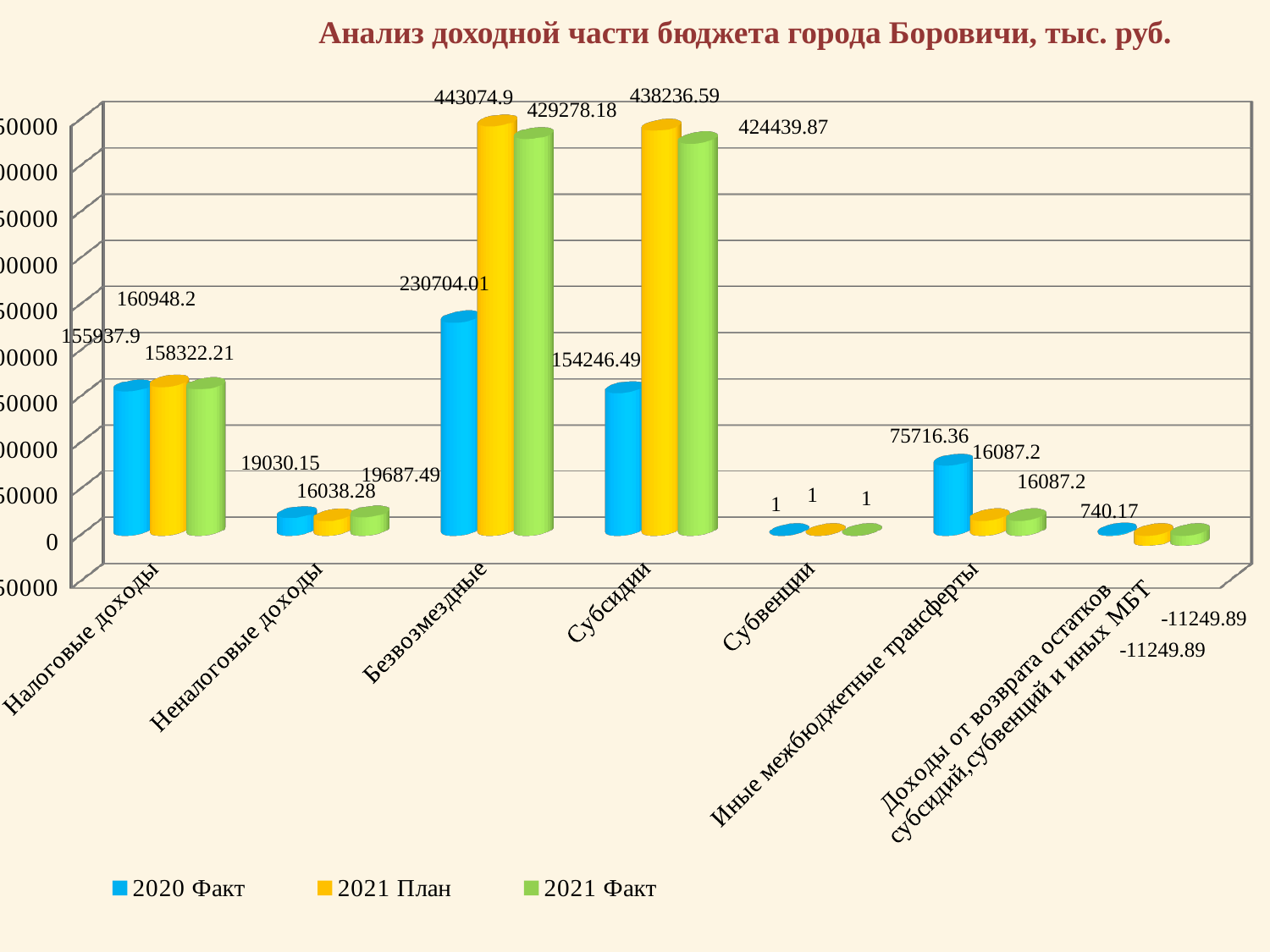
What is the 2021 План value for Безвозмездные? 443074.9 What kind of chart is shown on the slide? Bar chart What is the 2020 Факт value for Иные межбюджетные трансферты? 75716.36 What is the 2021 Факт value for Налоговые доходы? 158322.21 How many series does the legend list? 3 What is the 2020 Факт value for Субсидии? 154246.49 Which is larger for Неналоговые доходы: the 2020 Факт value or the 2021 План value? 2020 Факт What is the 2021 План value for Доходы от возврата остатков субсидий, субвенций и иных МБТ? -11249.89 Which category has the lowest 2021 Факт value? Доходы от возврата остатков субсидий, субвенций и иных МБТ Which category has the highest 2021 План value? Безвозмездные How many categories are shown on the x axis? 7 What is the difference between the 2021 План and 2021 Факт values for Субсидии? 13796.72